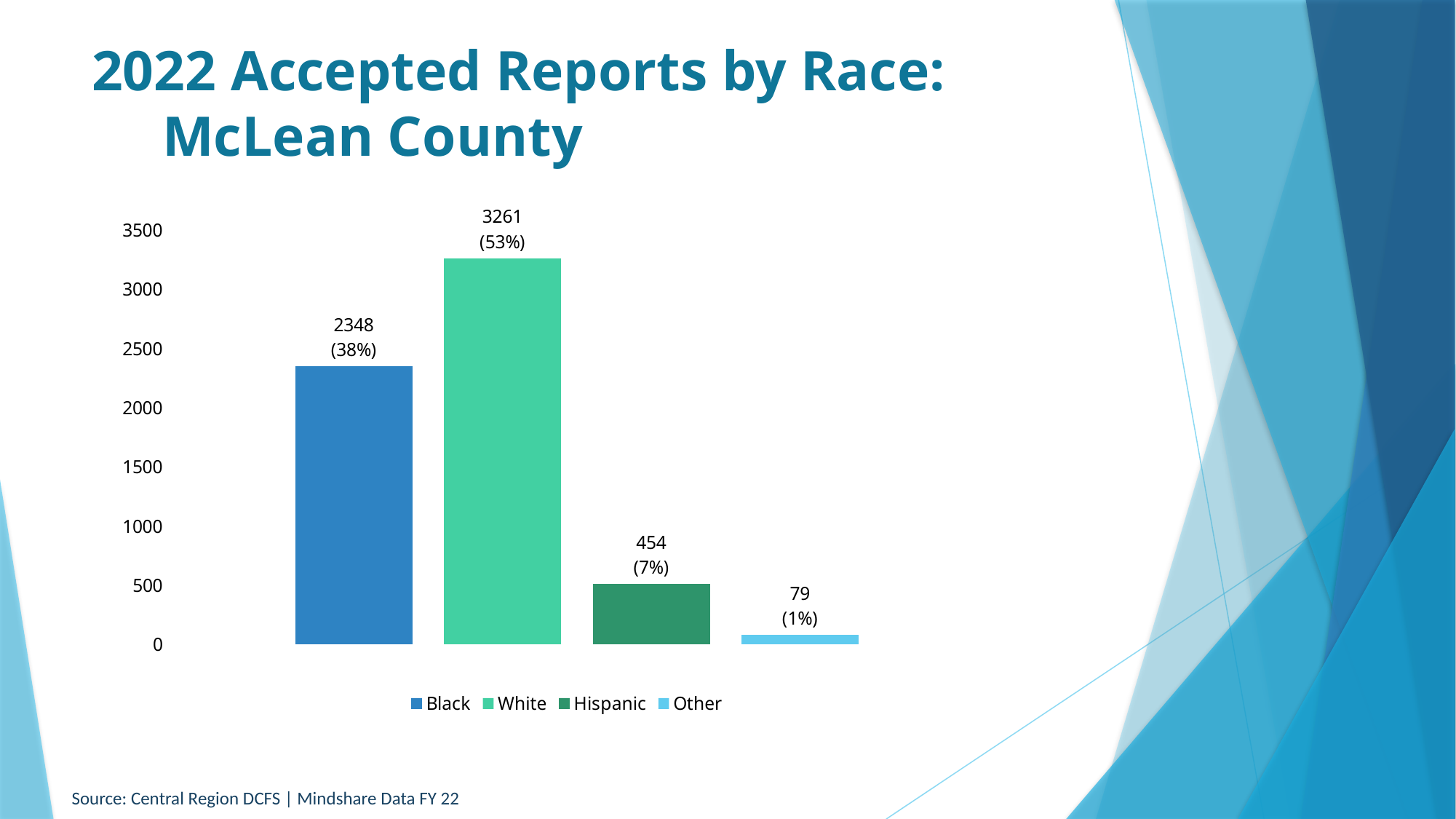
How many accepted reports are shown for Black? 2348 How many accepted reports are shown for Other? 79 Which race has the lowest number of accepted reports? Other Which has more accepted reports, Hispanic or Other? Hispanic How many accepted reports are shown for White? 3261 How many race categories are shown in the chart? 4 What is the source cited at the bottom of the slide? Central Region DCFS | Mindshare Data FY 22 What percentage is shown for Hispanic? 7% Is the value for Black greater or less than 2000? greater What kind of chart is shown on the slide? Bar chart What is the difference between the number of accepted reports for White and Black? 913 Which race has the highest number of accepted reports? White